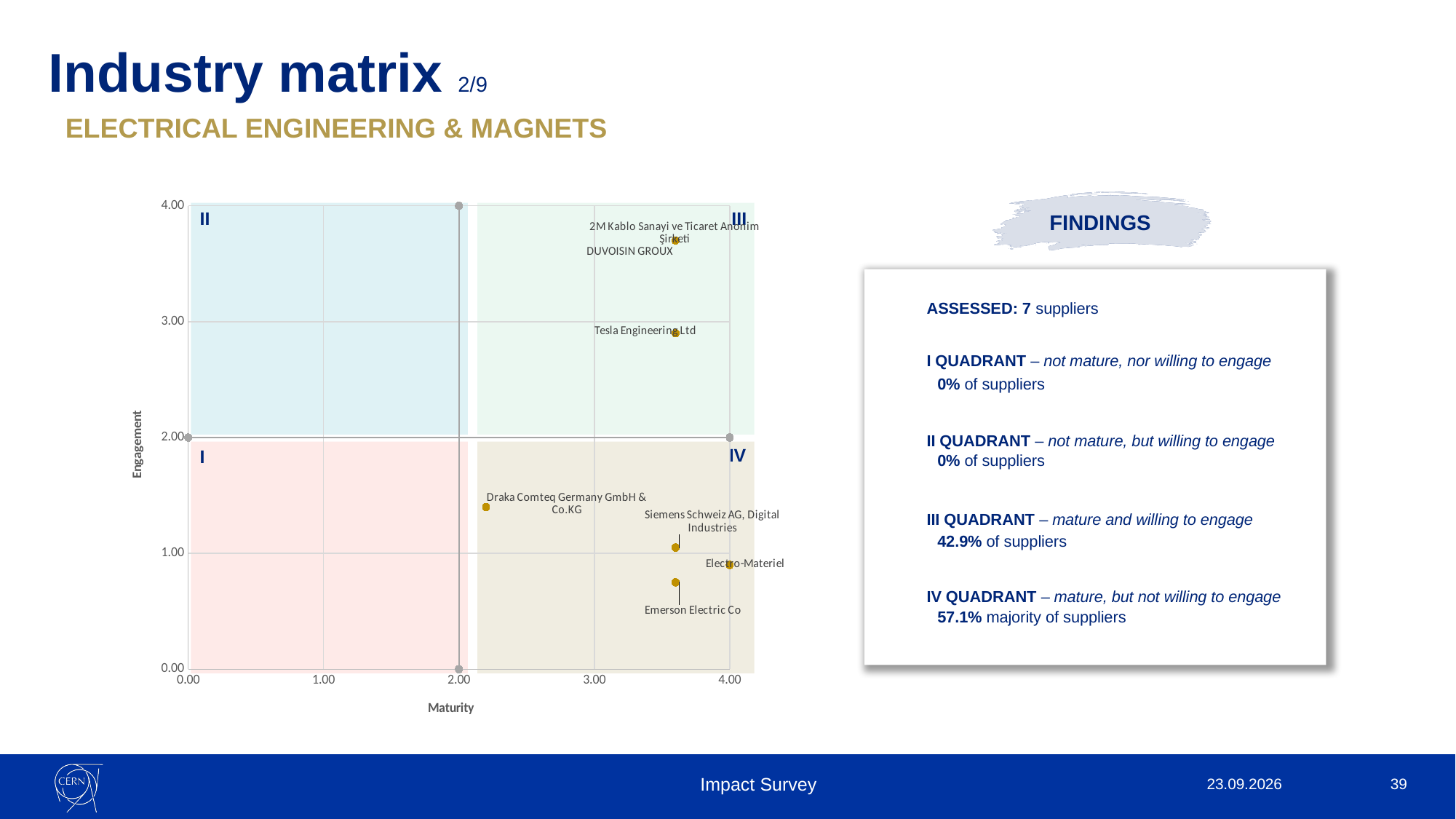
Is the Engagement value for Tesla Engineering Ltd greater or less than 2.00? greater What is the label of the vertical axis of the chart? Engagement What kind of chart is shown on the slide? Scatter chart Is the Engagement value for Tesla Engineering Ltd greater or less than 3.00? less How many suppliers are plotted on the industry matrix chart? 7 Is the Maturity value for Draka Comteq Germany GmbH & Co.KG greater or less than 3.00? less Which has the higher Maturity value, Siemens Schweiz AG, Digital Industries or Draka Comteq Germany GmbH & Co.KG? Siemens Schweiz AG, Digital Industries Which supplier has the lowest Maturity value on the chart? Draka Comteq Germany GmbH & Co.KG What is the label of the horizontal axis of the chart? Maturity Which has the higher Engagement value, Tesla Engineering Ltd or Draka Comteq Germany GmbH & Co.KG? Tesla Engineering Ltd